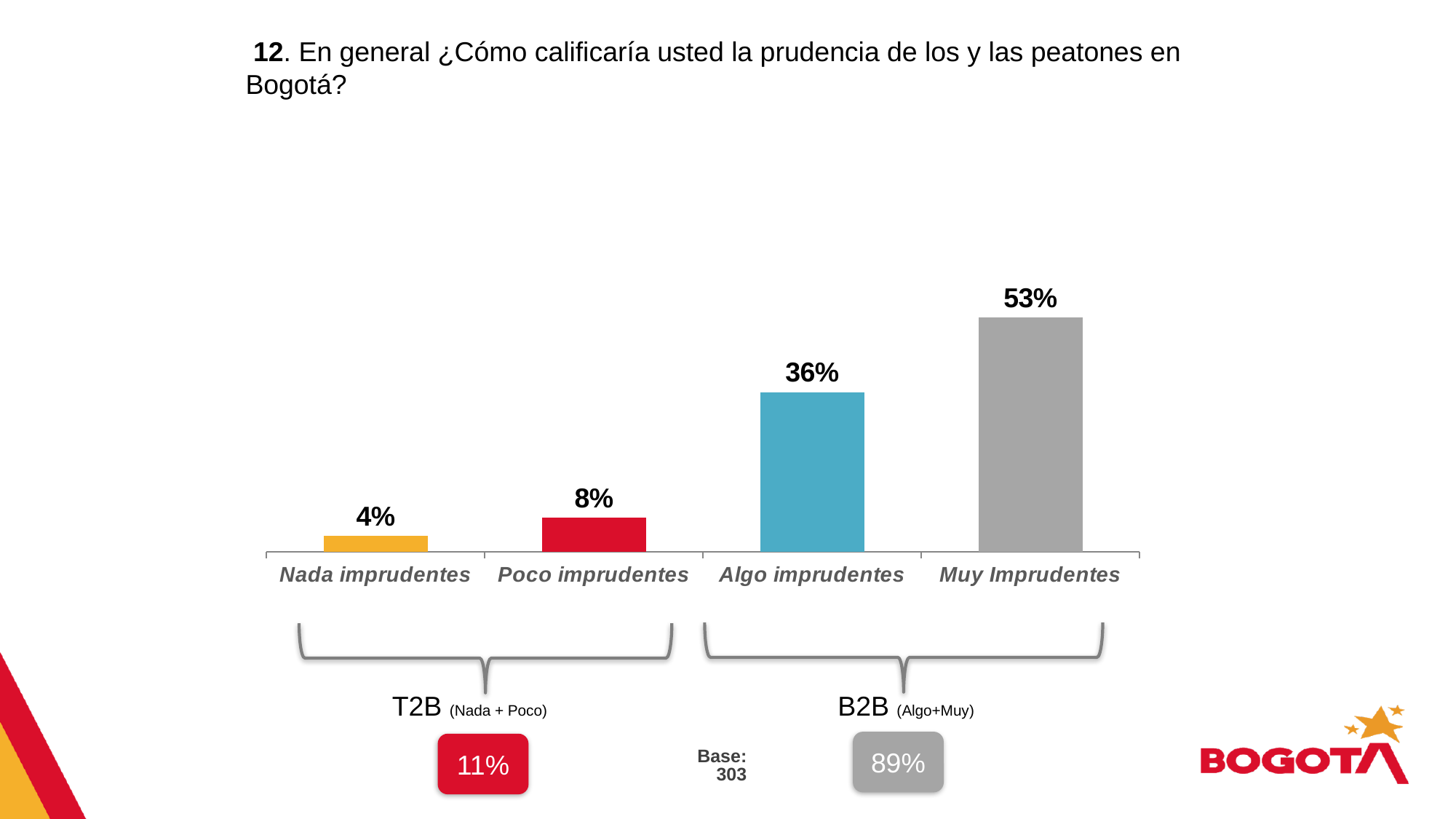
What kind of chart is shown on the slide? Bar chart What is the value for Nada imprudentes? 4% Which is larger, Poco imprudentes or Algo imprudentes? Algo imprudentes What is the difference between Muy Imprudentes and Algo imprudentes? 17% Do the values rise or fall from left to right across the categories? Rise What is the value for Algo imprudentes? 36% How many categories are shown in the chart? 4 What is the combined value shown for B2B (Algo+Muy)? 89% What is the value for Muy Imprudentes? 53% Which category has the lowest value? Nada imprudentes Which category has the highest value? Muy Imprudentes What is the value for Poco imprudentes? 8%